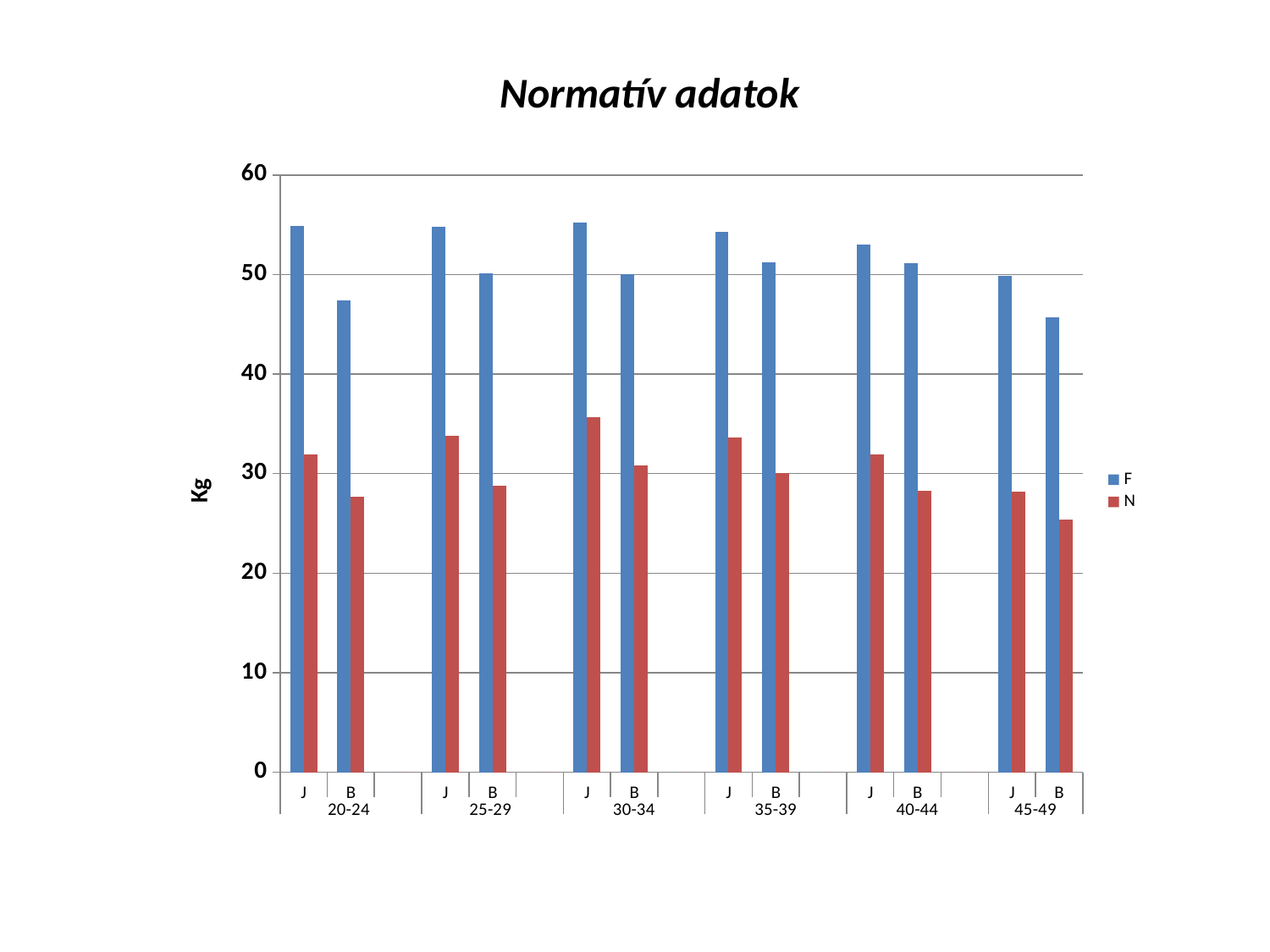
Is the N value for B in the 45-49 group greater or less than 30? less What is the title of the chart? Normatív adatok In the 20-24 group, which is larger for the F series: J or B? J What is the label on the vertical axis? Kg What kind of chart is shown on the slide? bar chart How many series does the legend list? 2 Is the F value for J in the 20-24 group greater or less than 50? greater Which bar has the lowest value for the F series? B in 45-49 How many age groups are shown along the x axis? 6 Which bar has the highest value for the N series? J in 30-34 Is the F value for B in the 45-49 group greater or less than 50? less Which bar has the lowest value for the N series? B in 45-49